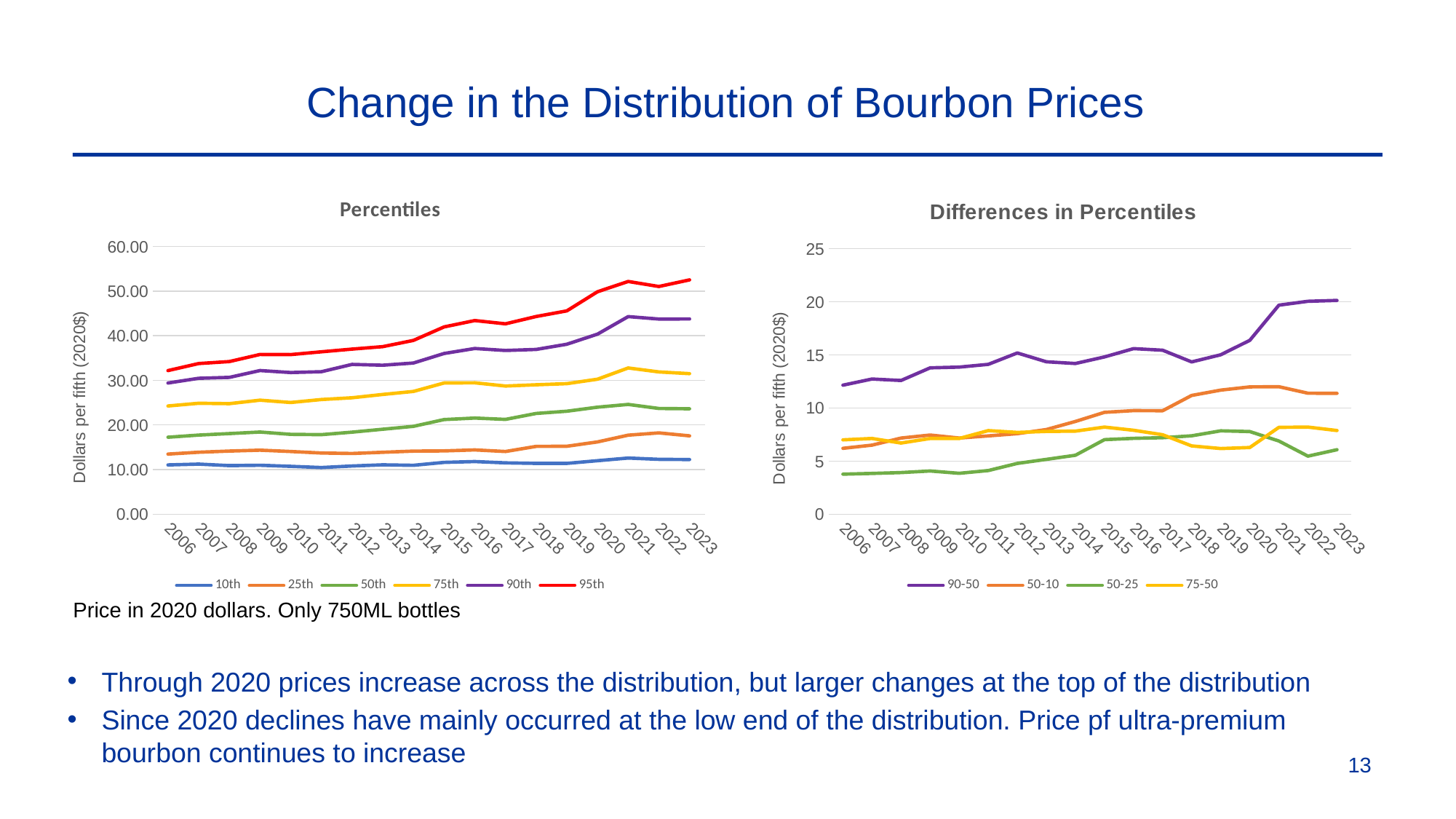
In the "Percentiles" chart, is the value for the 95th percentile in 2023 greater or less than 50.00? greater In the "Percentiles" chart, does the 95th percentile line generally rise or fall from 2006 to 2023? rise In the "Percentiles" chart, is the value for the 10th percentile in 2023 greater or less than 20.00? less How many series does the legend of the "Differences in Percentiles" chart list? 4 In the "Differences in Percentiles" chart, is the value for 90-50 in 2021 greater or less than 15? greater What kind of chart is the "Percentiles" chart on the left? line chart In the "Differences in Percentiles" chart, which is larger in 2023: 50-10 or 75-50? 50-10 How many years are shown on the x axis of the "Percentiles" chart? 18 In the "Percentiles" chart, which series has the highest values across all years? 95th In the "Percentiles" chart, which series has the lowest values across all years? 10th How many series does the legend of the "Percentiles" chart list? 6